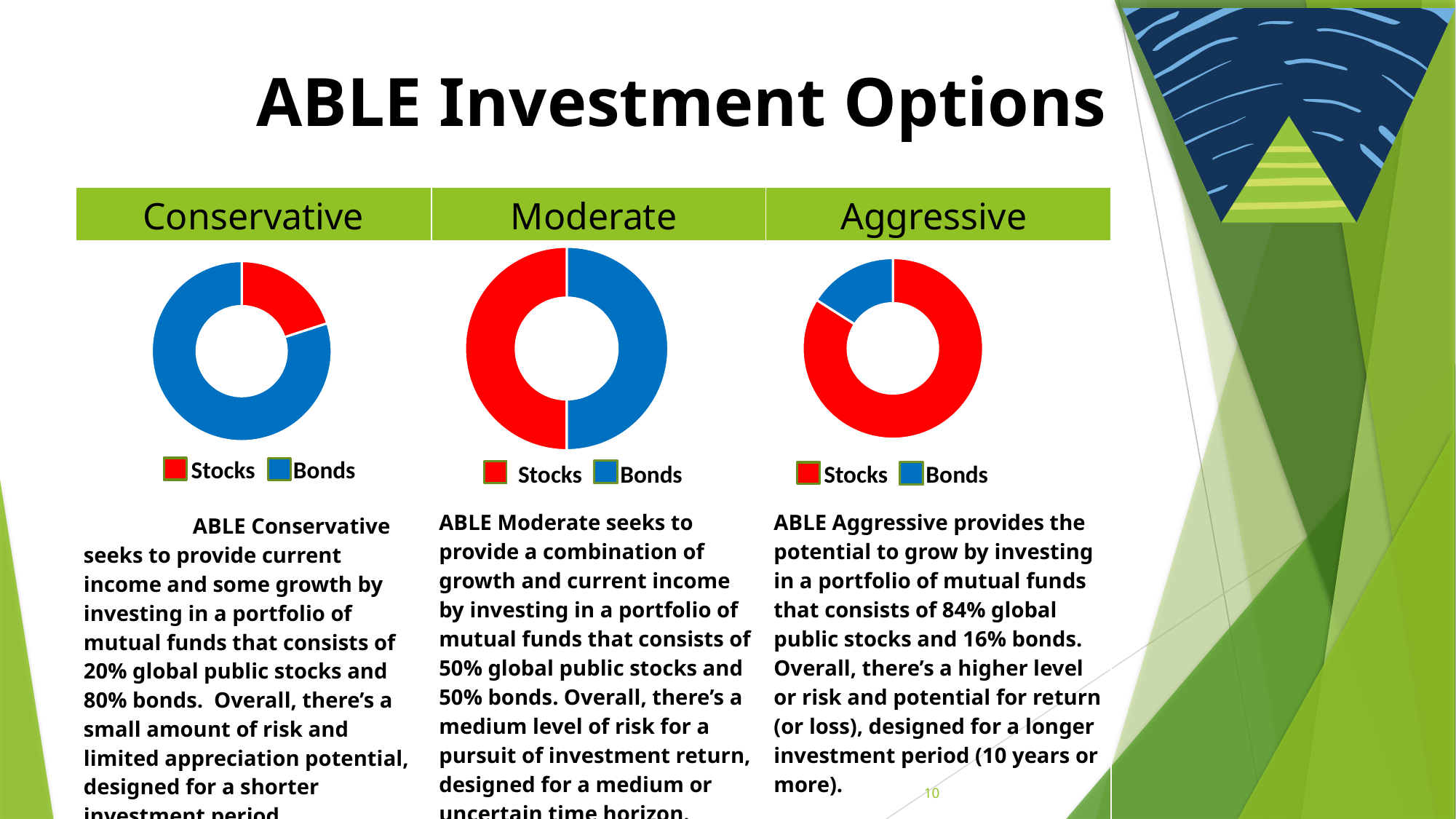
In the Aggressive chart, what share of the portfolio is Bonds? 16% In the Aggressive chart, which slice is larger, Stocks or Bonds? Stocks How many donut charts are shown on the slide? 3 How many series does the legend list for the Moderate chart? 2 In the Conservative chart, what share of the portfolio is Stocks? 20% What are the two legend entries for the Aggressive chart? Stocks and Bonds What kind of chart is used under the Conservative heading? Donut (pie) chart In the Aggressive chart, what share of the portfolio is Stocks? 84% Which colour represents Stocks in the three charts? Red In the Conservative chart, which slice is larger, Stocks or Bonds? Bonds